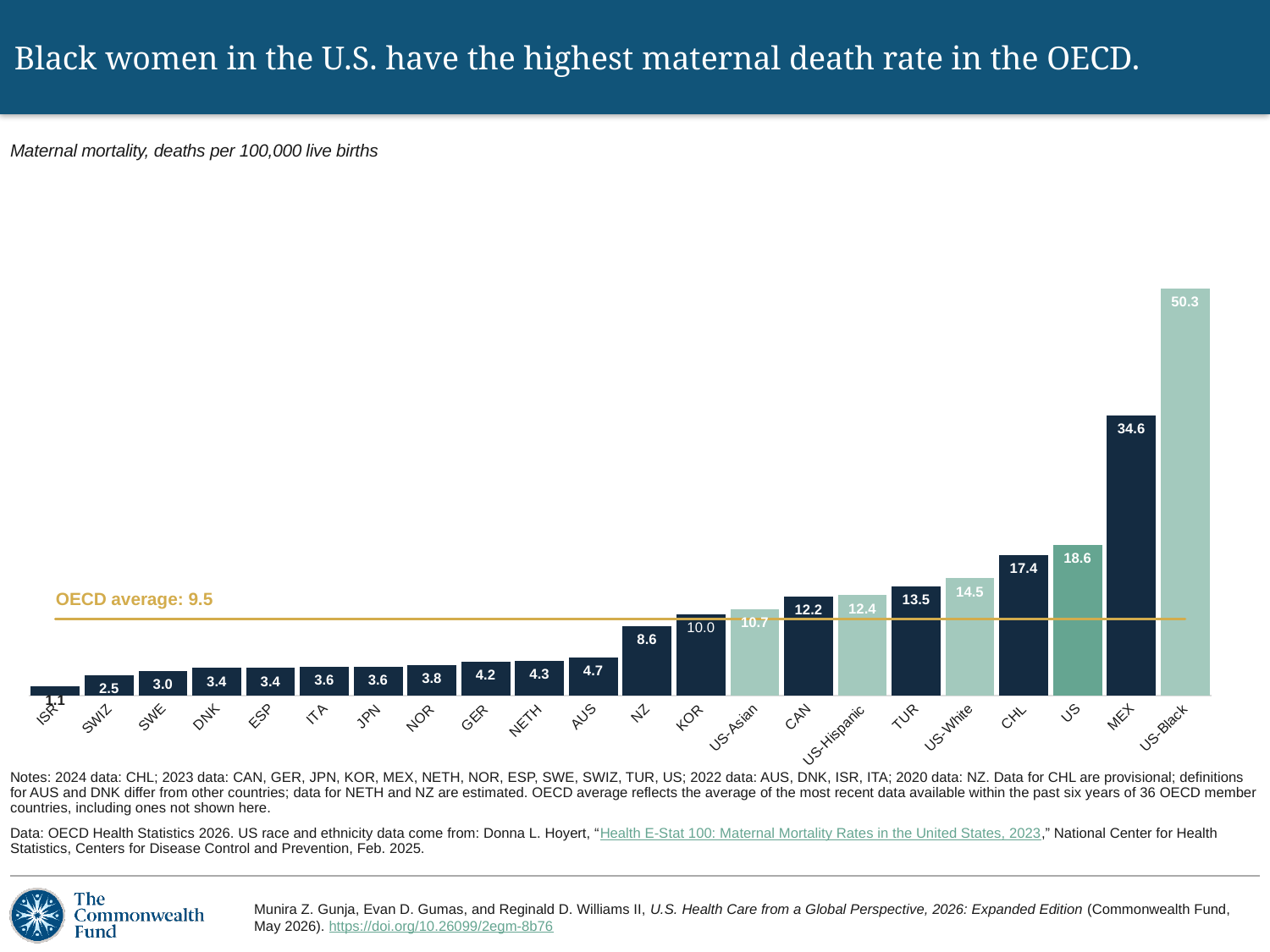
What kind of chart is shown on the slide? Bar chart What is the maternal mortality rate shown for US-Black? 50.3 What OECD average value is marked by the horizontal line on the chart? 9.5 Which category has the highest maternal mortality rate on the chart? US-Black What is the value shown for MEX? 34.6 What is the value shown for CAN? 12.2 Which category has the lowest maternal mortality rate on the chart? ISR Which has a higher value, US-Hispanic or US-Asian? US-Hispanic What is the difference between the values for US and US-White? 4.1 What is the difference between the values for US-Black and MEX? 15.7 How many bars (categories) are plotted on the chart? 22 Which has a higher maternal mortality rate, CHL or TUR? CHL